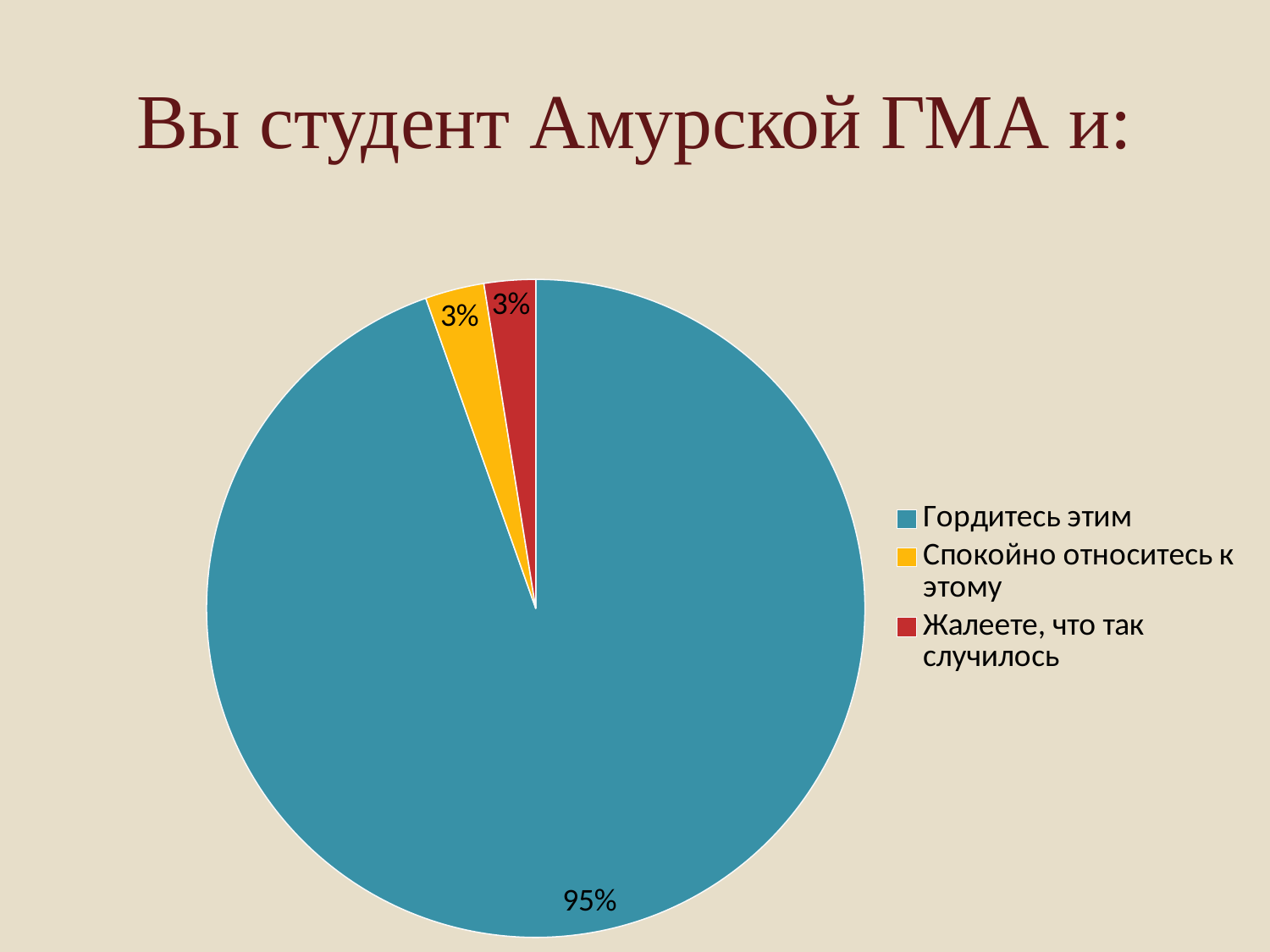
What share of the pie is labelled "Спокойно относитесь к этому"? 3% How many slices does the pie chart have? 3 What share of the pie is labelled "Гордитесь этим"? 95% Which is larger: the slice for "Гордитесь этим" or the slice for "Спокойно относитесь к этому"? Гордитесь этим What is the title of the slide? Вы студент Амурской ГМА и: What percentage of the pie does the blue slice represent? 95% What kind of chart is shown on the slide? Pie chart How many entries does the legend list? 3 What is the difference in percentage points between "Гордитесь этим" and "Жалеете, что так случилось"? 92 Which category has the largest slice of the pie? Гордитесь этим What share of the pie is labelled "Жалеете, что так случилось"? 3% What colour is the slice for "Жалеете, что так случилось"? Red